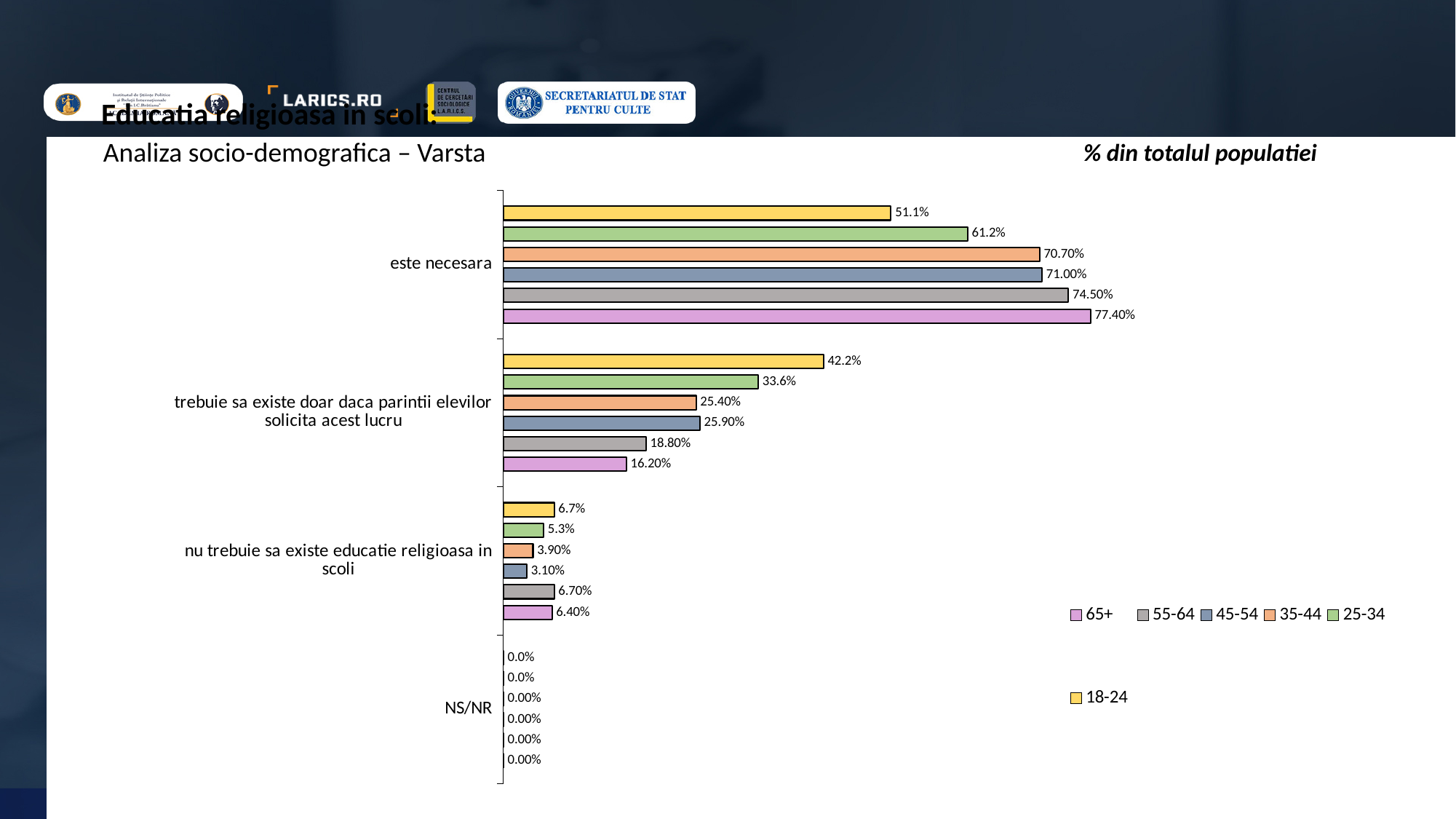
What is the difference between the 65+ and 18-24 values for "este necesara"? 26.3% What is the value for the 45-54 age group for "nu trebuie sa existe educatie religioasa in scoli"? 3.10% How many response categories are shown on the vertical axis? 4 For "trebuie sa existe doar daca parintii elevilor solicita acest lucru", which is larger: the value for 25-34 or the value for 55-64? 25-34 What is the value for the 18-24 age group for "trebuie sa existe doar daca parintii elevilor solicita acest lucru"? 42.2% How many series does the legend list? 6 What is the value for the 65+ age group for "este necesara"? 77.40% Which age group has the lowest value for "trebuie sa existe doar daca parintii elevilor solicita acest lucru"? 65+ Which age group has the highest value for "este necesara"? 65+ What kind of chart is shown on the slide? bar chart What is the value for the 35-44 age group for NS/NR? 0.00% What is the subtitle shown above the chart on the left? Analiza socio-demografica – Varsta